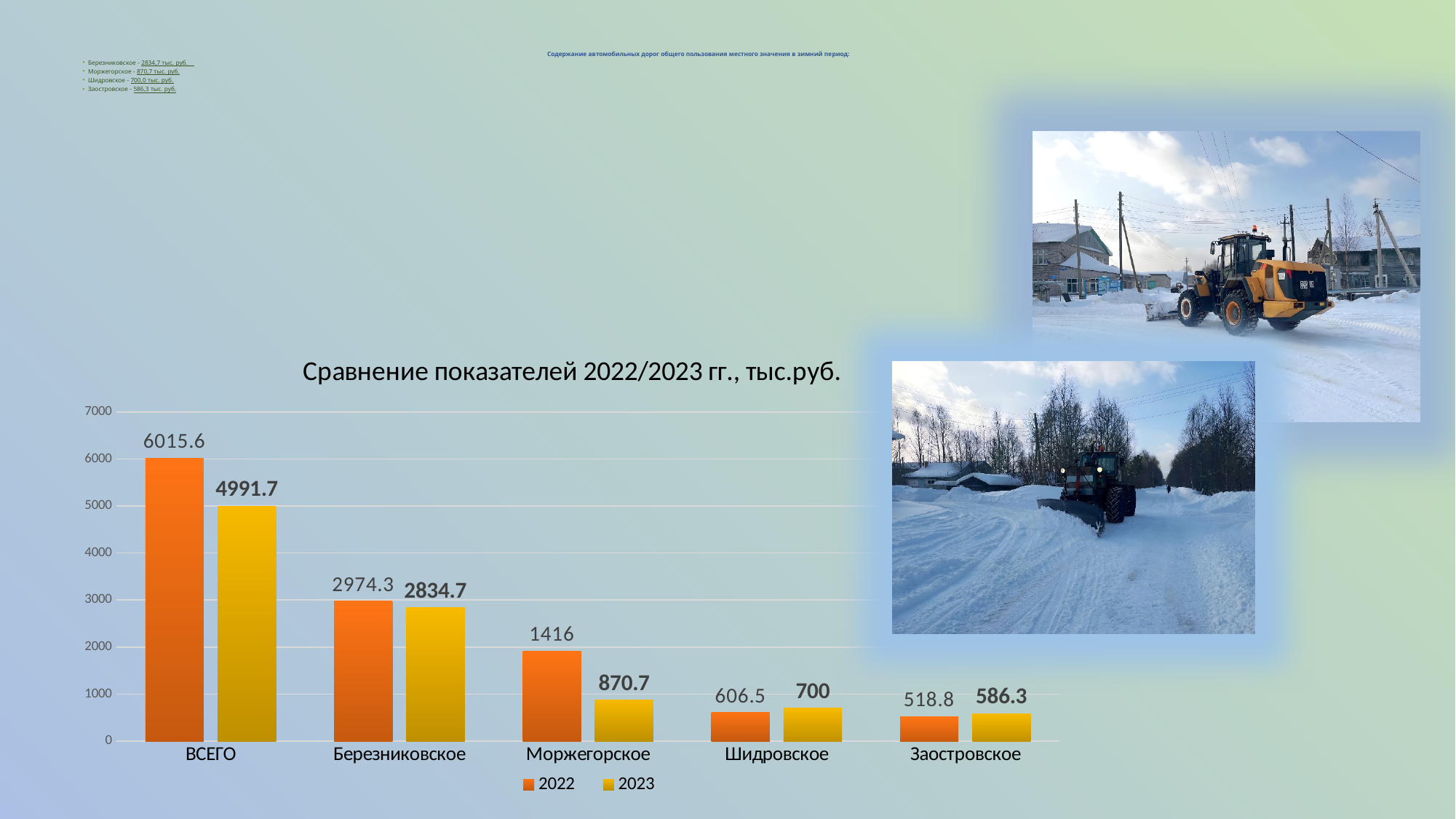
What is the title of the chart? Сравнение показателей 2022/2023 гг., тыс.руб. What is the 2023 value for Моржегорское? 870.7 How many categories are shown on the x axis? 5 Which category has the lowest 2022 value? Заостровское What kind of chart is shown? Bar chart Which category has the highest 2023 value? ВСЕГО Which is larger for Шидровское, the 2022 value or the 2023 value? 2023 What is the 2022 value for ВСЕГО? 6015.6 What is the 2023 value for Заостровское? 586.3 How many series does the legend list? 2 What is the difference between the 2022 and 2023 values for ВСЕГО? 1023.9 What is the 2022 value for Шидровское? 606.5